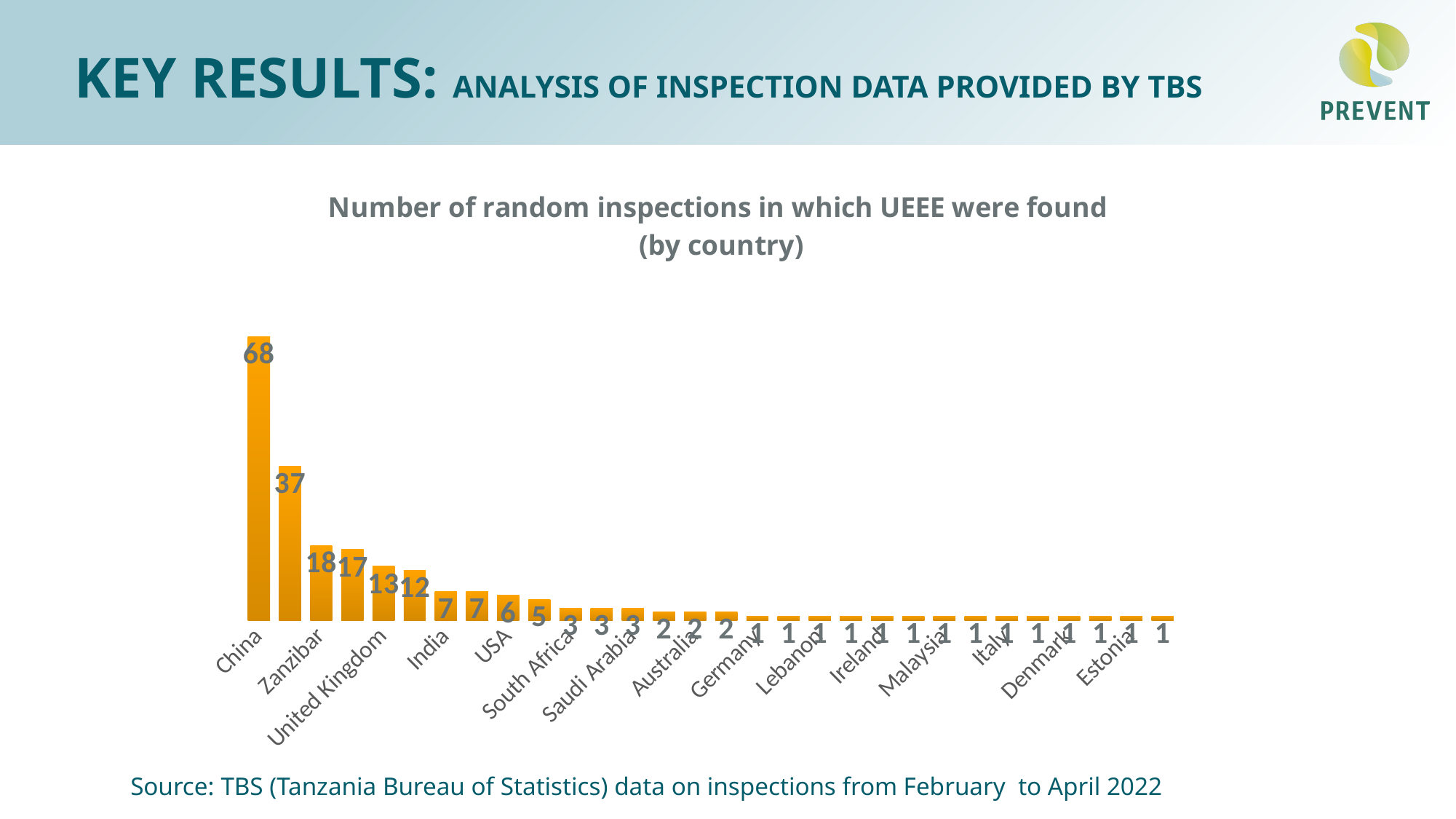
What is the value for Lebanon? 1 What is the value for Estonia? 1 What is the source of the data shown in the chart? TBS (Tanzania Bureau of Statistics) data on inspections from February to April 2022 Which country has the highest number of random inspections in which UEEE were found? China What is the title of the chart? Number of random inspections in which UEEE were found (by country) Which is larger, the value for India or the value for USA? India What is the difference between the two tallest bars in the chart? 31 What is the value for China? 68 Which is larger, the value for China or the value for Zanzibar? China What kind of chart is shown on the slide? bar chart What is the value for Denmark? 1 Do the values rise or fall from left to right along the x axis? fall